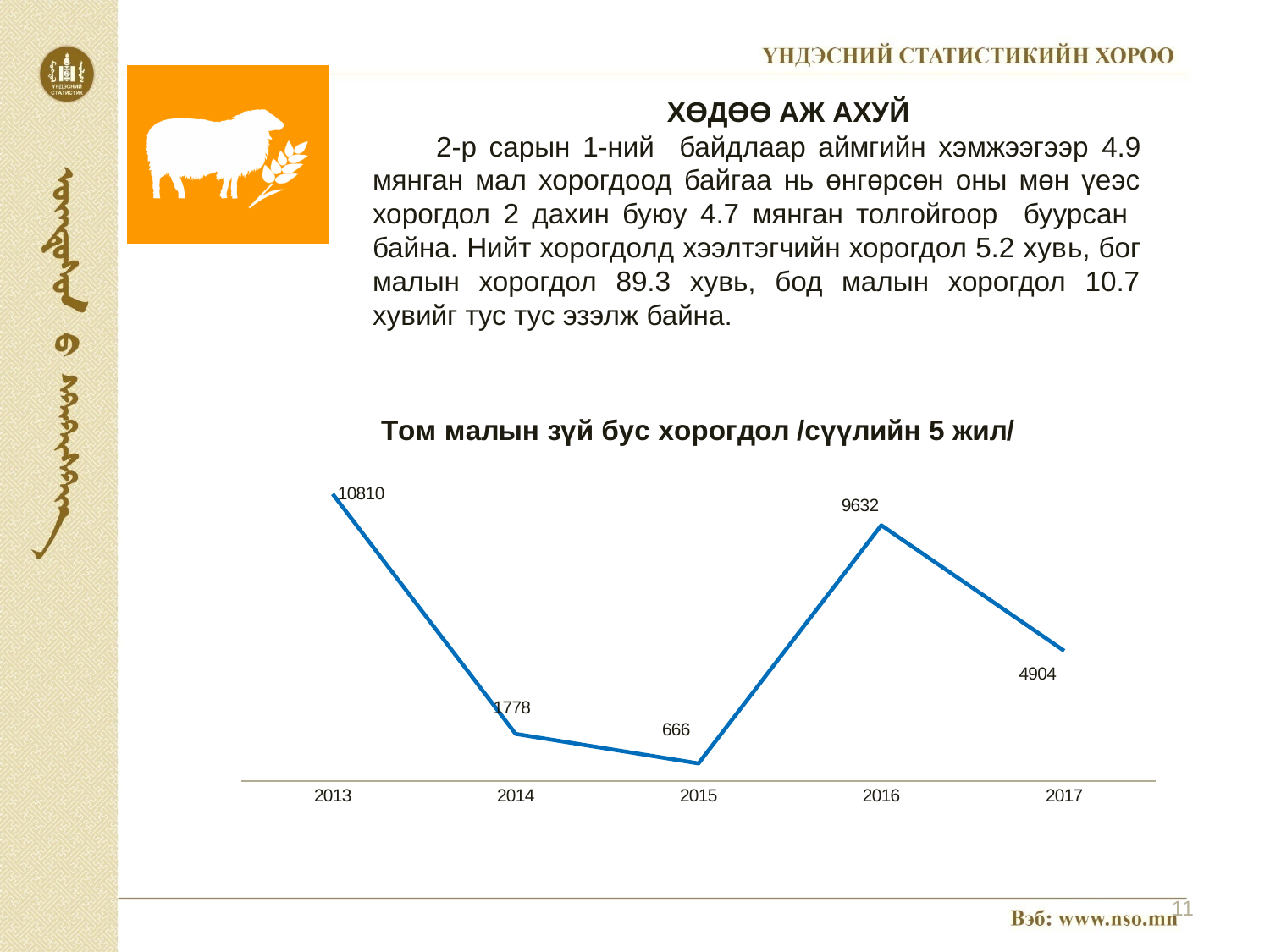
What is the title of the chart? Том малын зүй бус хорогдол /сүүлийн 5 жил/ What is the difference between the values for 2016 and 2017? 4728 Which year has the highest value? 2013 What is the value for 2015? 666 How many years are plotted on the chart? 5 What is the value for 2013? 10810 What is the difference between the values for 2014 and 2015? 1112 What kind of chart is shown on the slide? line chart Which is larger, the value for 2013 or the value for 2016? 2013 What is the value for 2017? 4904 Which year has the lowest value? 2015 Do the values rise or fall from 2013 to 2015? fall